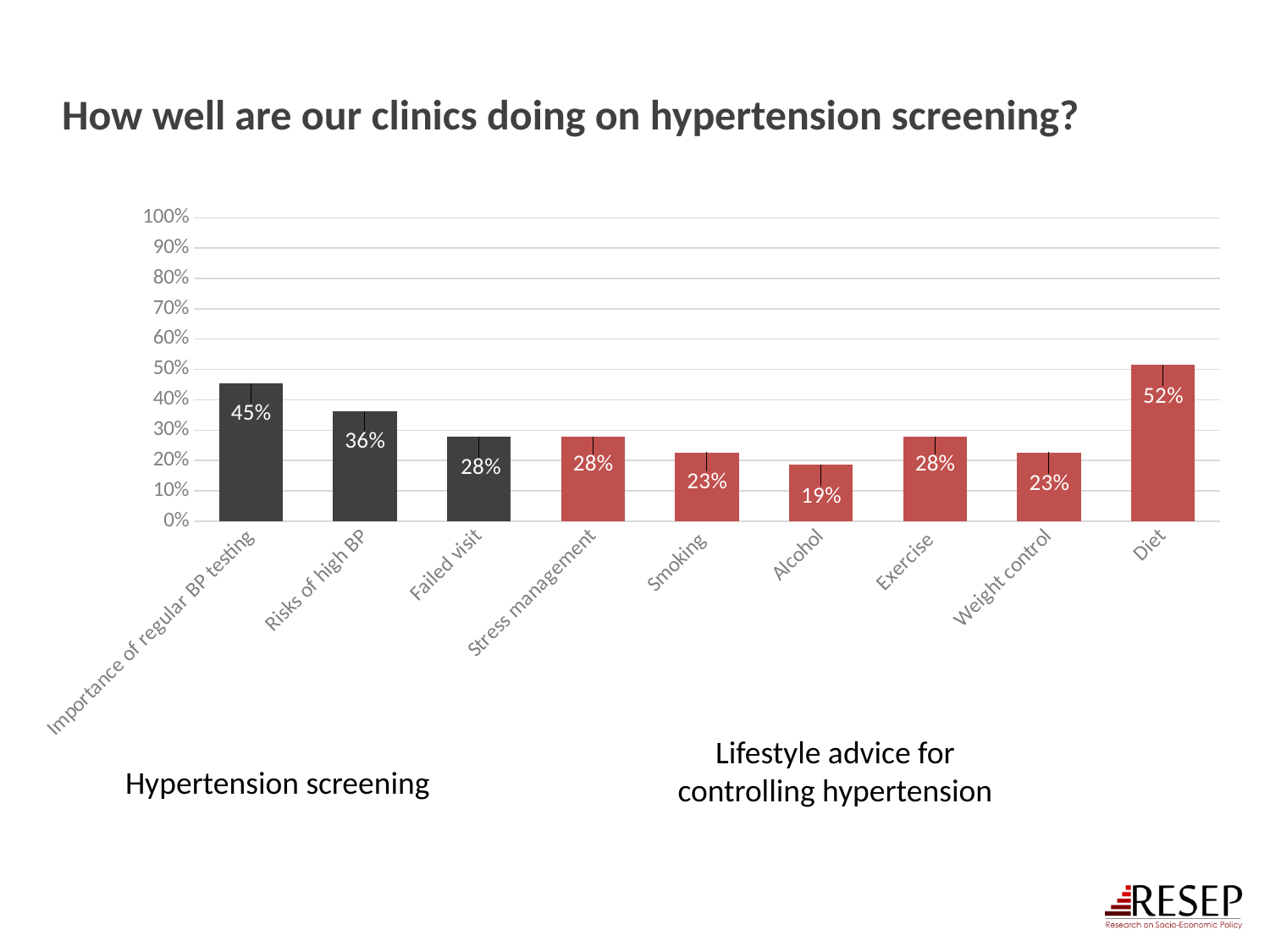
Which category has the highest value? Diet What is the value for Risks of high BP? 36% What kind of chart is shown on the slide? Bar chart Which category has the lowest value? Alcohol What is the value for Alcohol? 19% What is the title of the slide? How well are our clinics doing on hypertension screening? What is the difference between the values for Importance of regular BP testing and Risks of high BP? 9% What is the difference between the values for Diet and Alcohol? 33% How many categories are shown on the x axis? 9 Which is larger, the value for Smoking or the value for Exercise? Exercise What is the value for Importance of regular BP testing? 45% What is the value for Diet? 52%